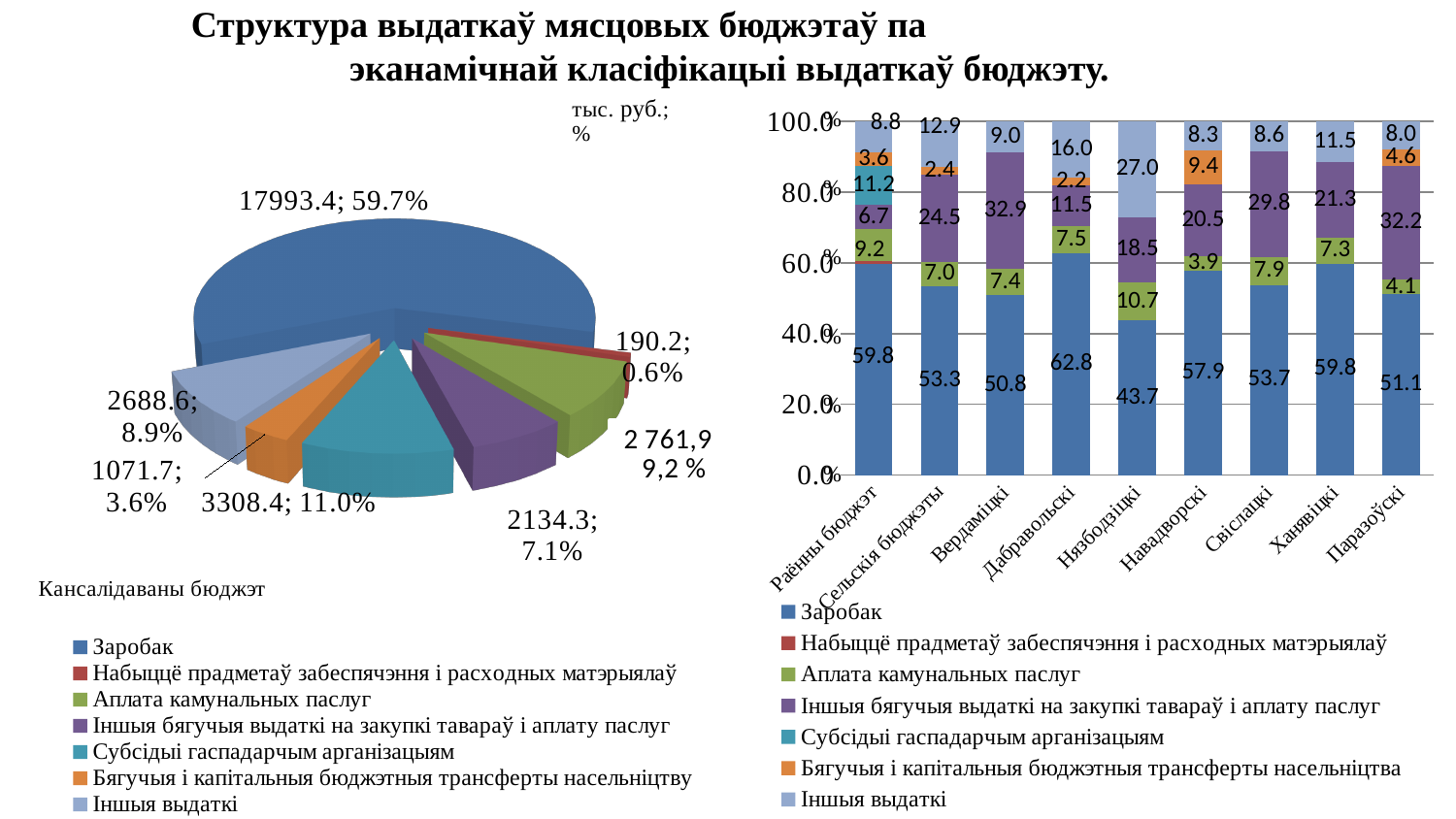
On the pie chart (Кансалідаваны бюджэт), what kind of chart is shown? pie chart On the stacked bar chart on the right, how many categories are shown on the x axis? 9 On the pie chart (Кансалідаваны бюджэт), which category has the smallest slice? Набыццё прадметаў забеспячэння і расходных матэрыялаў On the stacked bar chart on the right, what is the Іншыя выдаткі value for Нязбодзіцкі? 27.0 On the pie chart (Кансалідаваны бюджэт), what percentage share does Заробак have? 59.7% On the stacked bar chart on the right, what is the Заробак value for Нязбодзіцкі? 43.7 On the pie chart (Кансалідаваны бюджэт), what is the value for Іншыя выдаткі? 2688.6 On the stacked bar chart on the right, how many series does the legend list? 7 On the stacked bar chart on the right, which category has the lowest Заробак value? Нязбодзіцкі On the stacked bar chart on the right, which category has the highest Заробак value? Дабравольскі On the pie chart (Кансалідаваны бюджэт), what is the value for Субсідыі гаспадарчым арганізацыям? 3308.4 On the stacked bar chart on the right, what is the difference between the Заробак values for Дабравольскі and Нязбодзіцкі? 19.1